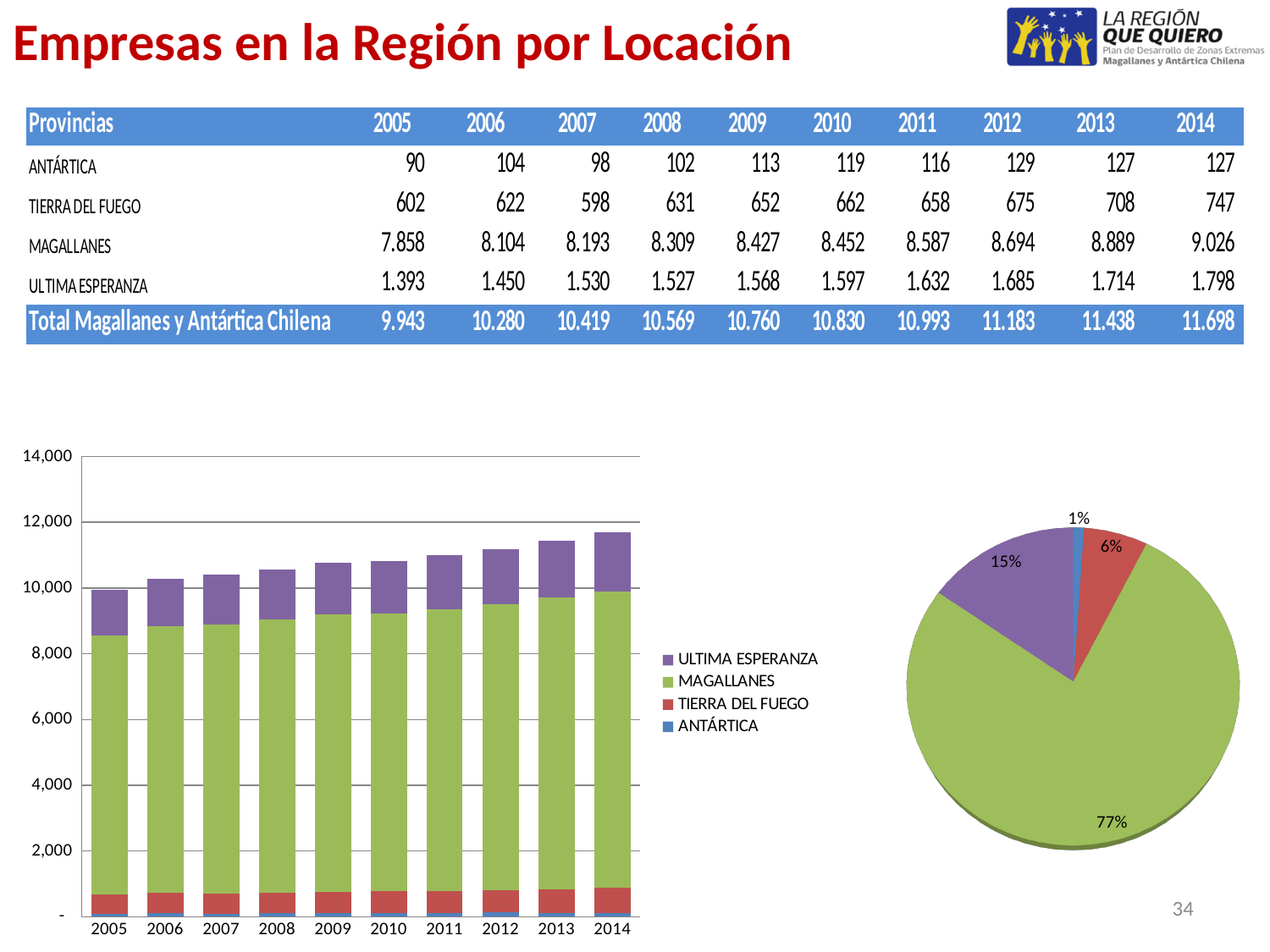
In the pie chart, what share does the MAGALLANES slice have? 77% In the bar chart on the left, do the total bar heights rise or fall from 2005 to 2014? rise What kind of chart is the chart on the left of the slide? Stacked bar chart In the pie chart, which province has the smallest slice? ANTÁRTICA How many series does the legend of the bar chart list? 4 What kind of chart is the chart on the right of the slide? Pie chart In the bar chart on the left, is the total stacked bar for 2005 greater or less than 12,000? less In the bar chart on the left, is the total stacked bar for 2014 greater or less than 10,000? greater In the bar chart on the left, which colour represents MAGALLANES? Green In the pie chart, what share does the TIERRA DEL FUEGO slice have? 6% In the pie chart, what share does the ULTIMA ESPERANZA slice have? 15% In the bar chart on the left, how many years are shown on the x axis? 10